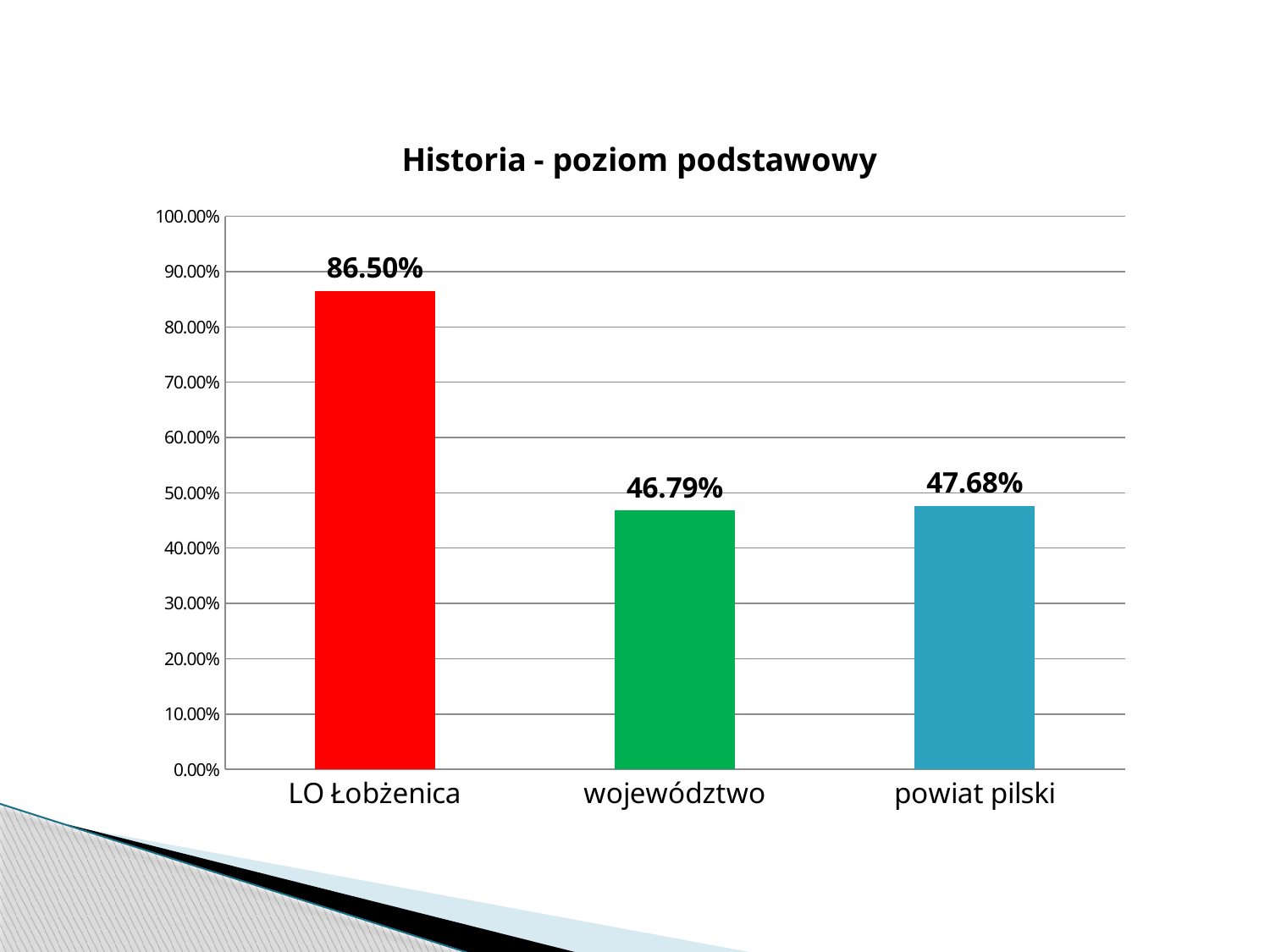
How many categories are shown on the x axis? 3 What is the value for LO Łobżenica? 86.50% Which category has the lowest value? województwo Which category has the highest value? LO Łobżenica What is the title of the chart? Historia - poziom podstawowy What kind of chart is shown on the slide? bar chart Is the value for LO Łobżenica greater or less than 80.00%? greater Which is larger, the value for LO Łobżenica or the value for województwo? LO Łobżenica What is the value for województwo? 46.79% What is the difference between the values for LO Łobżenica and powiat pilski? 38.82% What is the difference between the values for powiat pilski and województwo? 0.89% What is the value for powiat pilski? 47.68%